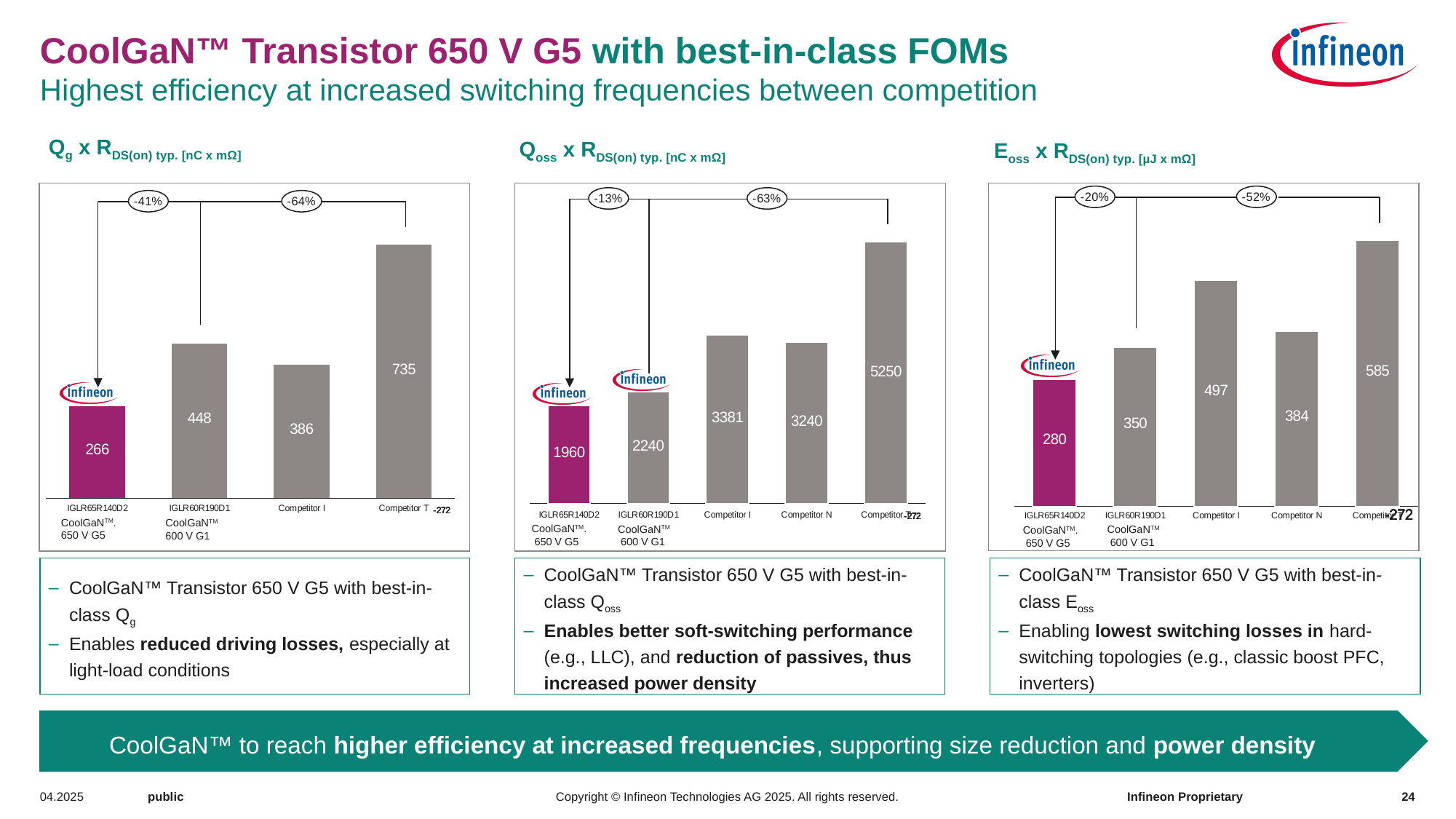
In the Qg x RDS(on) chart, what is the difference between Competitor T and IGLR60R190D1 (CoolGaN 600 V G1)? 287 How many bars are shown in the Qoss x RDS(on) chart? 5 How many bars are shown in the Qg x RDS(on) chart? 4 In the Qoss x RDS(on) chart, what is the value for Competitor N? 3240 In the Qg x RDS(on) chart, which category has the highest value? Competitor T What type of chart is the Eoss x RDS(on) chart? Bar chart In the Eoss x RDS(on) chart, what is the value for Competitor I? 497 In the Eoss x RDS(on) chart, what is the difference between Competitor T and IGLR65R140D2 (CoolGaN 650 V G5)? 305 In the Qoss x RDS(on) chart, which category has the lowest value? IGLR65R140D2 (CoolGaN 650 V G5) In the Qoss x RDS(on) chart, which is larger, Competitor I or Competitor N? Competitor I In the Eoss x RDS(on) chart, what percentage reduction is annotated between IGLR65R140D2 and Competitor T? -52% In the Qg x RDS(on) chart, what is the value for IGLR65R140D2 (CoolGaN 650 V G5)? 266